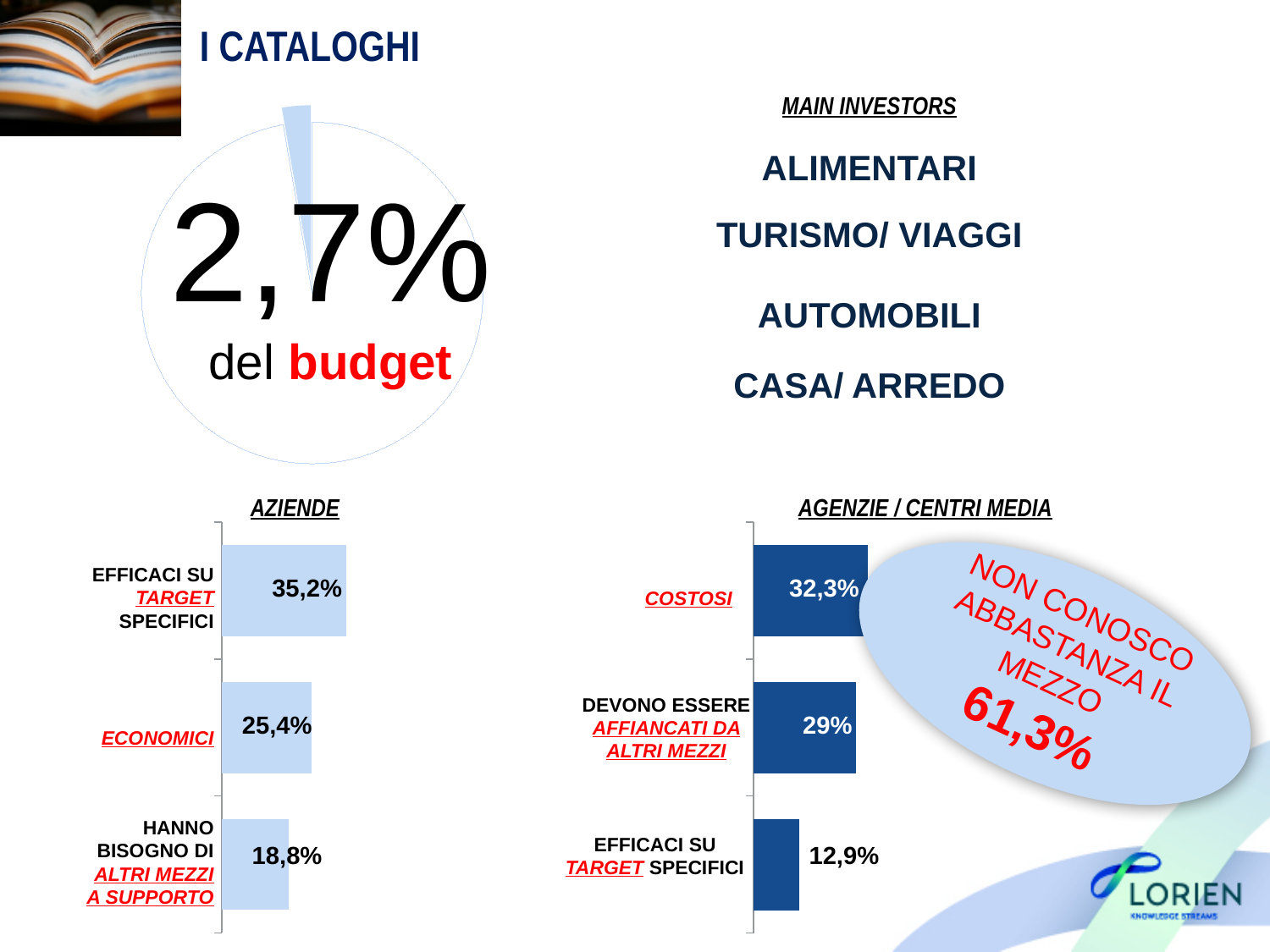
In the AGENZIE / CENTRI MEDIA chart, which category has the highest value? COSTOSI In the AZIENDE chart, what is the difference between EFFICACI SU TARGET SPECIFICI and HANNO BISOGNO DI ALTRI MEZZI A SUPPORTO? 16,4% In the AGENZIE / CENTRI MEDIA chart, what is the difference between COSTOSI and DEVONO ESSERE AFFIANCATI DA ALTRI MEZZI? 3,3% What share of the budget does the pie chart at the top left show for cataloghi? 2,7% Which is larger: ECONOMICI in the AZIENDE chart or DEVONO ESSERE AFFIANCATI DA ALTRI MEZZI in the AGENZIE / CENTRI MEDIA chart? DEVONO ESSERE AFFIANCATI DA ALTRI MEZZI In the AGENZIE / CENTRI MEDIA chart, what is the value for EFFICACI SU TARGET SPECIFICI? 12,9% In the AGENZIE / CENTRI MEDIA chart, what is the value for COSTOSI? 32,3% In the AZIENDE chart, what is the value for EFFICACI SU TARGET SPECIFICI? 35,2% In the AZIENDE chart, which category has the lowest value? HANNO BISOGNO DI ALTRI MEZZI A SUPPORTO What kind of chart is the AGENZIE / CENTRI MEDIA chart? Bar chart How many categories does the AZIENDE chart show? 3 In the AZIENDE chart, what is the value for ECONOMICI? 25,4%